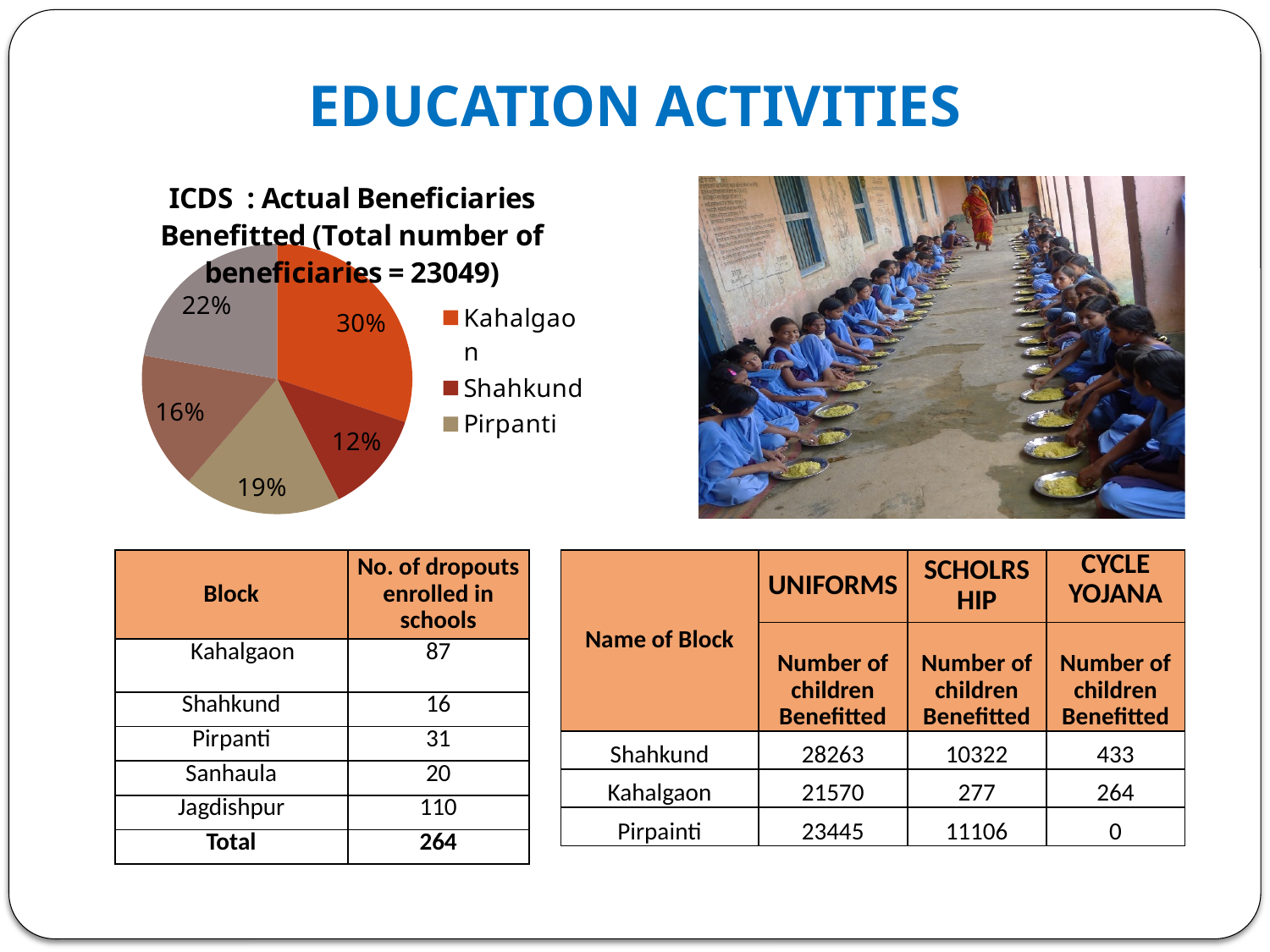
In the pie chart, what percentage share is shown for Shahkund? 12% Which labelled block has the largest slice in the pie chart? Kahalgaon In the pie chart, which is larger: the share for Kahalgaon or the share for Pirpanti? Kahalgaon How many slices does the pie chart have? 5 How many entries does the pie chart's legend list? 3 Which slice of the pie chart is the smallest? 12% (Shahkund) In the pie chart, what percentage share is shown for Pirpanti? 19% According to the pie chart's title, what is the total number of beneficiaries? 23049 What kind of chart is shown under the title 'ICDS : Actual Beneficiaries Benefitted'? pie chart What colour is the Kahalgaon slice in the pie chart? orange By how many percentage points does Kahalgaon's share exceed Shahkund's share in the pie chart? 18 percentage points In the pie chart, what percentage share is shown for Kahalgaon? 30%